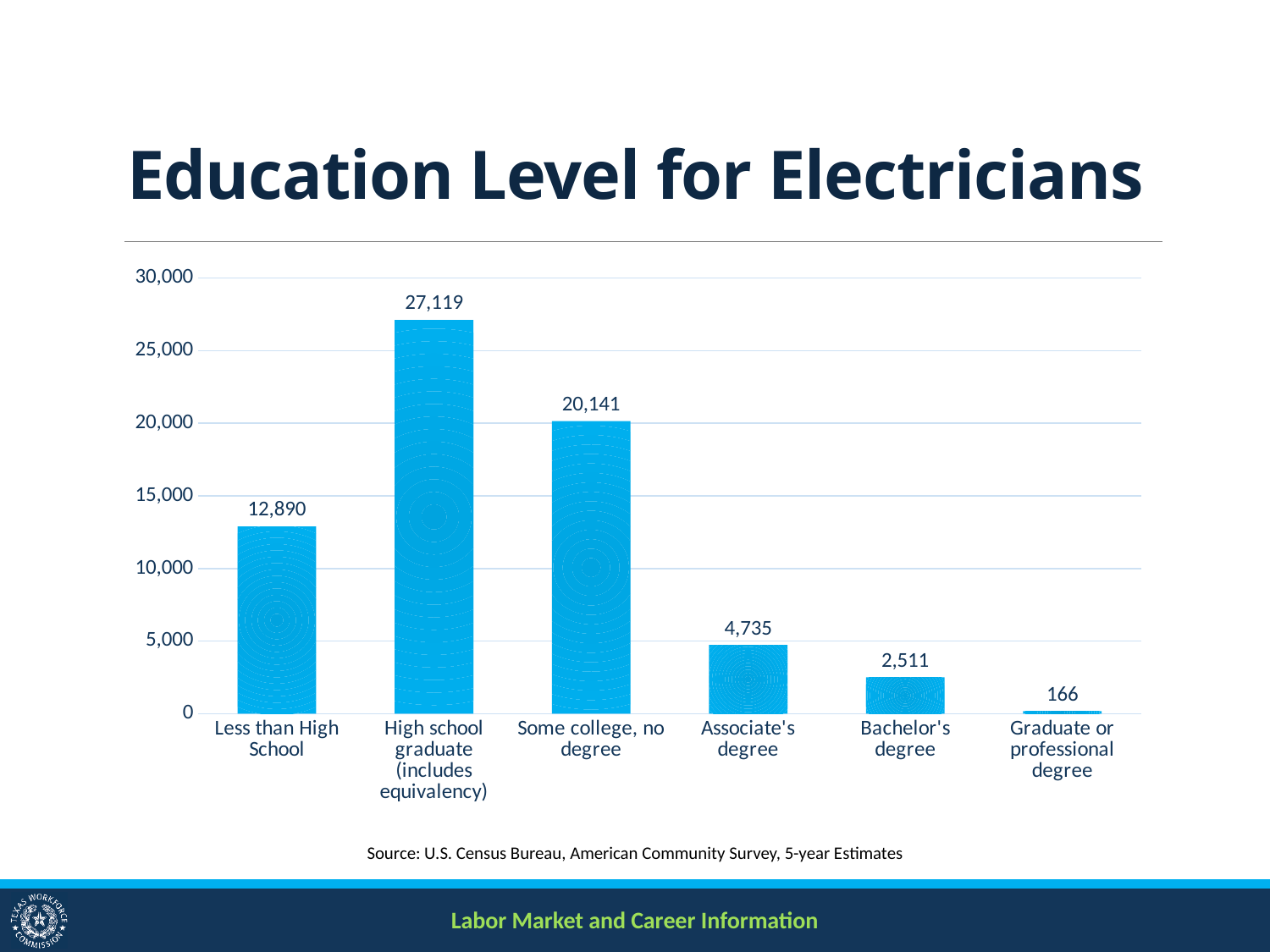
What is the difference between the values for High school graduate (includes equivalency) and Some college, no degree? 6,978 Which education level has the lowest value? Graduate or professional degree What is the value for Associate's degree? 4,735 Which education level has the highest value? High school graduate (includes equivalency) Which is larger, the value for Less than High School or the value for Some college, no degree? Some college, no degree How many education level categories are shown in the chart? 6 Is the value for Less than High School greater or less than 15,000? less What kind of chart is shown on the slide? bar chart What is the title of the chart? Education Level for Electricians What is the value for High school graduate (includes equivalency)? 27,119 What is the value for Graduate or professional degree? 166 What is the difference between the values for Less than High School and Bachelor's degree? 10,379